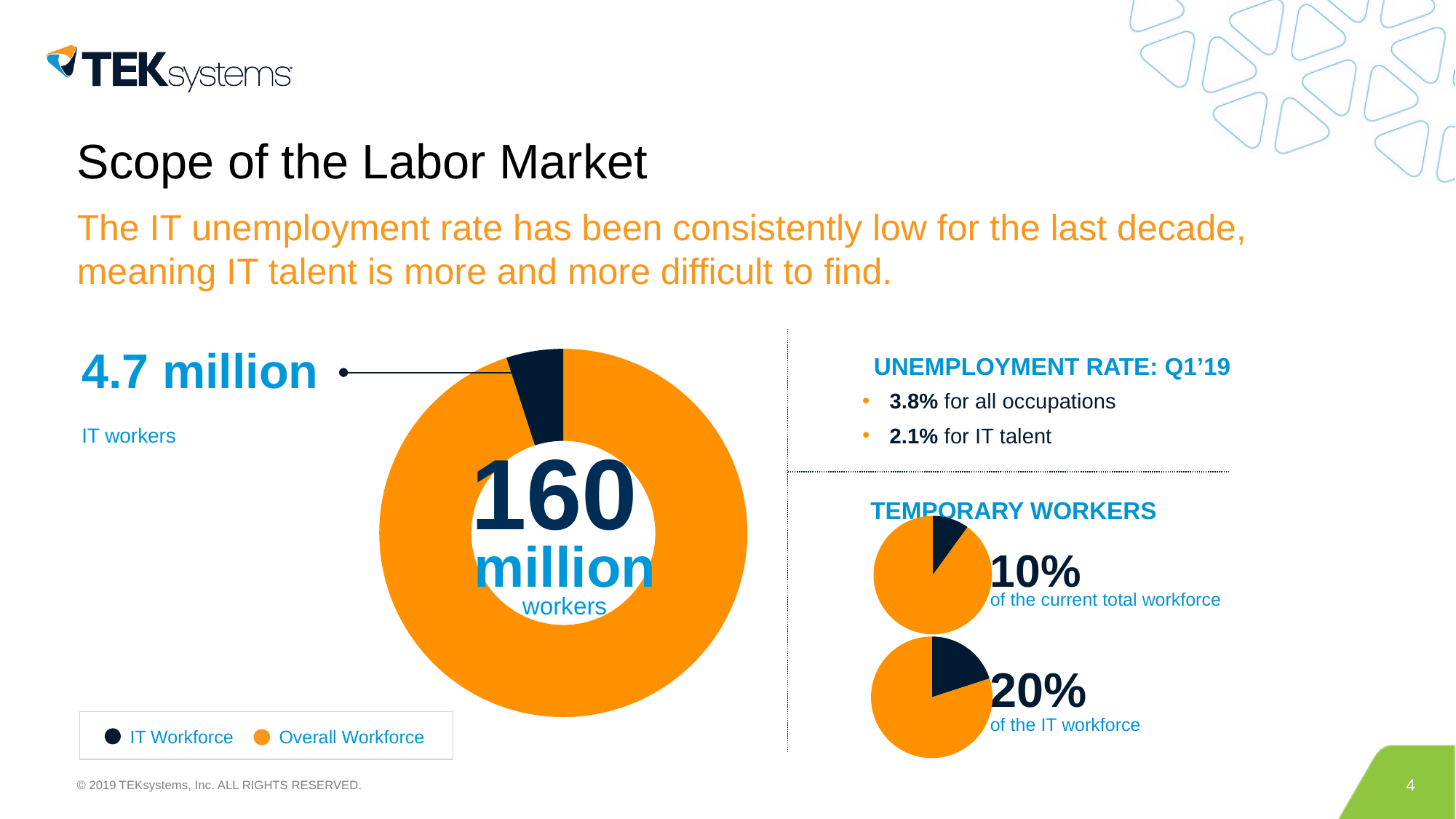
What is the heading above the two small pie charts on the right of the slide? TEMPORARY WORKERS Of the two small pie charts under Temporary Workers, which has the larger dark slice, the top one (current total workforce) or the bottom one (IT workforce)? the bottom one (IT workforce) Under Temporary Workers, what is the difference between the share of the IT workforce and the share of the current total workforce? 10 percentage points In the large pie chart, which slice is larger, IT Workforce or Overall Workforce? Overall Workforce What kind of chart is the large chart in the centre of the slide? doughnut chart In the large pie chart, how many IT workers are shown? 4.7 million In the legend of the large pie chart, what colour represents Overall Workforce? orange In the top small pie chart under Temporary Workers, what share of the current total workforce is shown? 10% In the bottom small pie chart under Temporary Workers, what share of the IT workforce is shown? 20% In the large pie chart, what total number of workers is printed in the centre? 160 million How many series does the legend below the large pie chart list? 2 In the large pie chart, how many slices are there? 2